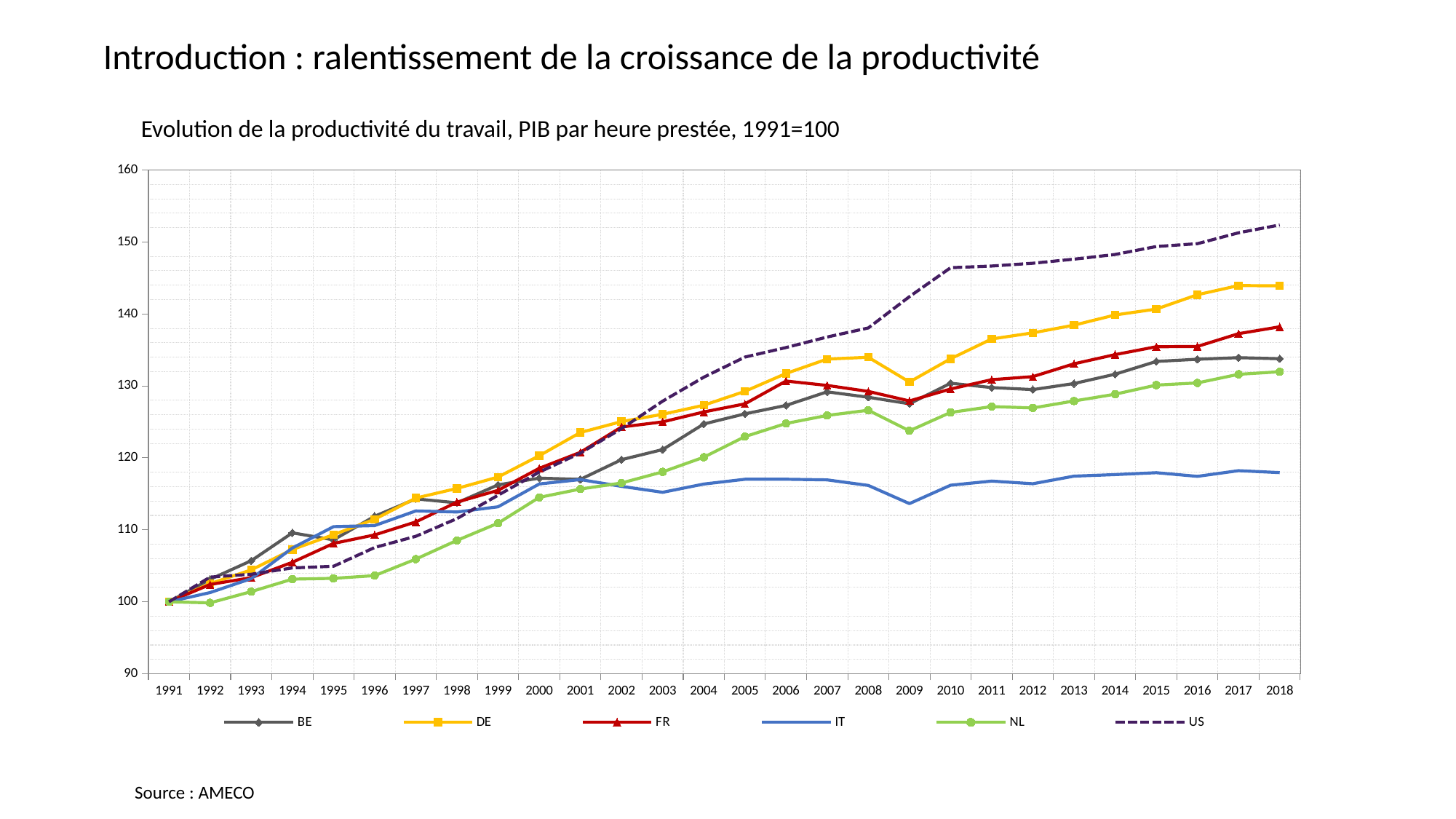
Is the value for DE in 2018 greater or less than 140? greater Which is larger in 2018, the value for DE or the value for FR? DE Is the value for IT in 2018 greater or less than 120? less Which series is drawn with a dashed line? US Does the US series generally rise or fall from 1991 to 2018? rise Which series has the lowest value in 2018? IT How many years are plotted along the x axis? 28 Which series has the highest value in 2018? US How many series does the legend list? 6 What is the value of every series in 1991? 100 What kind of chart is shown on the slide? line chart Is the value for US in 2018 greater or less than 150? greater